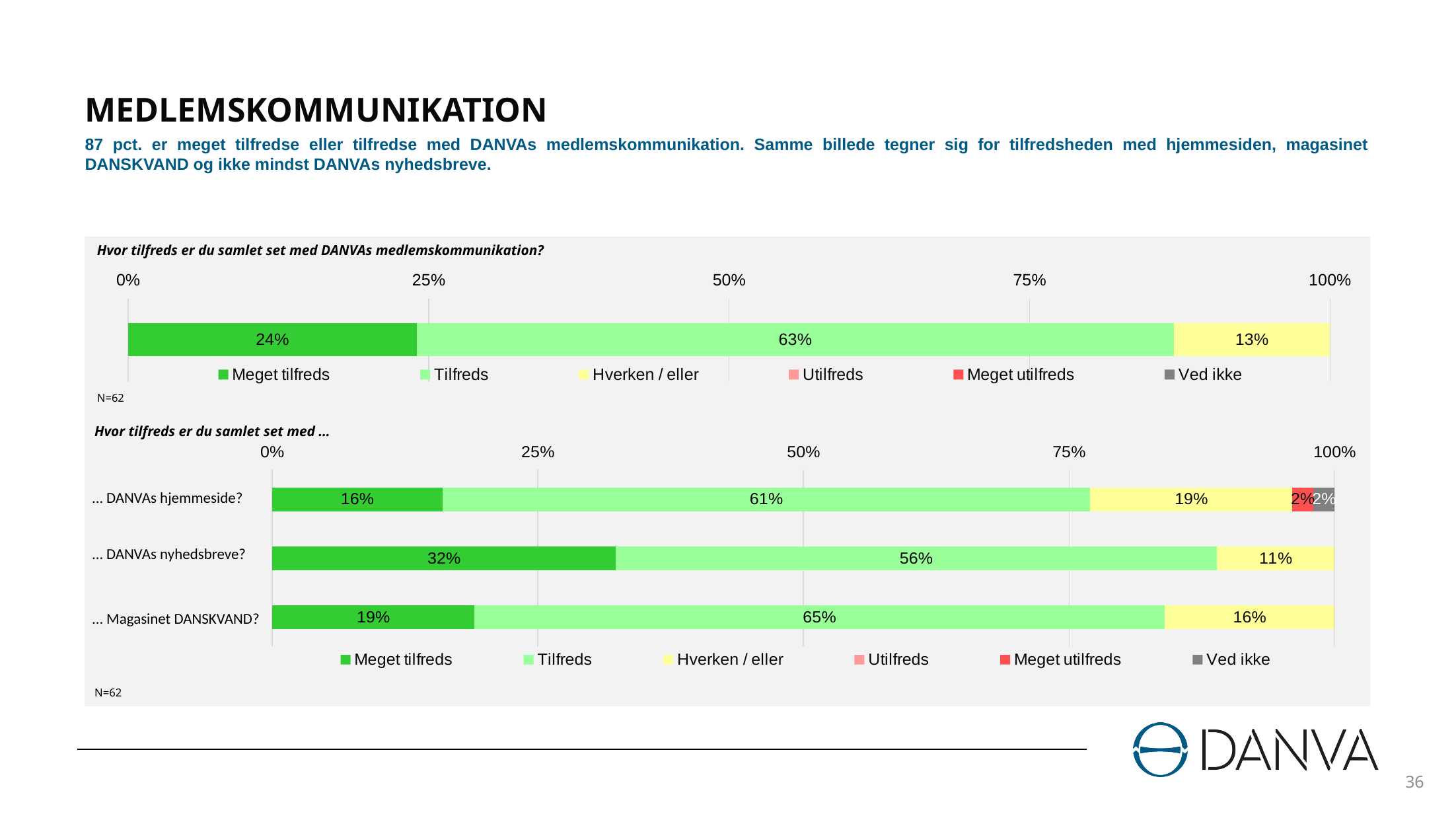
In the bottom chart 'Hvor tilfreds er du samlet set med ...', what is the 'Meget tilfreds' value for '... DANVAs nyhedsbreve?'? 32% In the bottom chart 'Hvor tilfreds er du samlet set med ...', what is the 'Hverken / eller' value for '... DANVAs hjemmeside?'? 19% In the bottom chart 'Hvor tilfreds er du samlet set med ...', which category has the highest 'Meget tilfreds' share? ... DANVAs nyhedsbreve? In the bottom chart 'Hvor tilfreds er du samlet set med ...', what is the difference between the 'Meget tilfreds' values for '... DANVAs nyhedsbreve?' and '... DANVAs hjemmeside?'? 16% In the bottom chart 'Hvor tilfreds er du samlet set med ...', which category has the lowest 'Meget tilfreds' share? ... DANVAs hjemmeside? In the top chart 'Hvor tilfreds er du samlet set med DANVAs medlemskommunikation?', what percentage is 'Tilfreds'? 63% In the top chart 'Hvor tilfreds er du samlet set med DANVAs medlemskommunikation?', what percentage is 'Meget tilfreds'? 24% In the bottom chart 'Hvor tilfreds er du samlet set med ...', what is the 'Tilfreds' value for '... Magasinet DANSKVAND?'? 65% How many categories are shown in the bottom chart 'Hvor tilfreds er du samlet set med ...'? 3 How many series does the legend of the top chart 'Hvor tilfreds er du samlet set med DANVAs medlemskommunikation?' list? 6 In the bottom chart 'Hvor tilfreds er du samlet set med ...', is the 'Tilfreds' value larger for '... DANVAs hjemmeside?' or '... DANVAs nyhedsbreve?'? ... DANVAs hjemmeside? In the top chart 'Hvor tilfreds er du samlet set med DANVAs medlemskommunikation?', what is the combined share of 'Meget tilfreds' and 'Tilfreds'? 87%